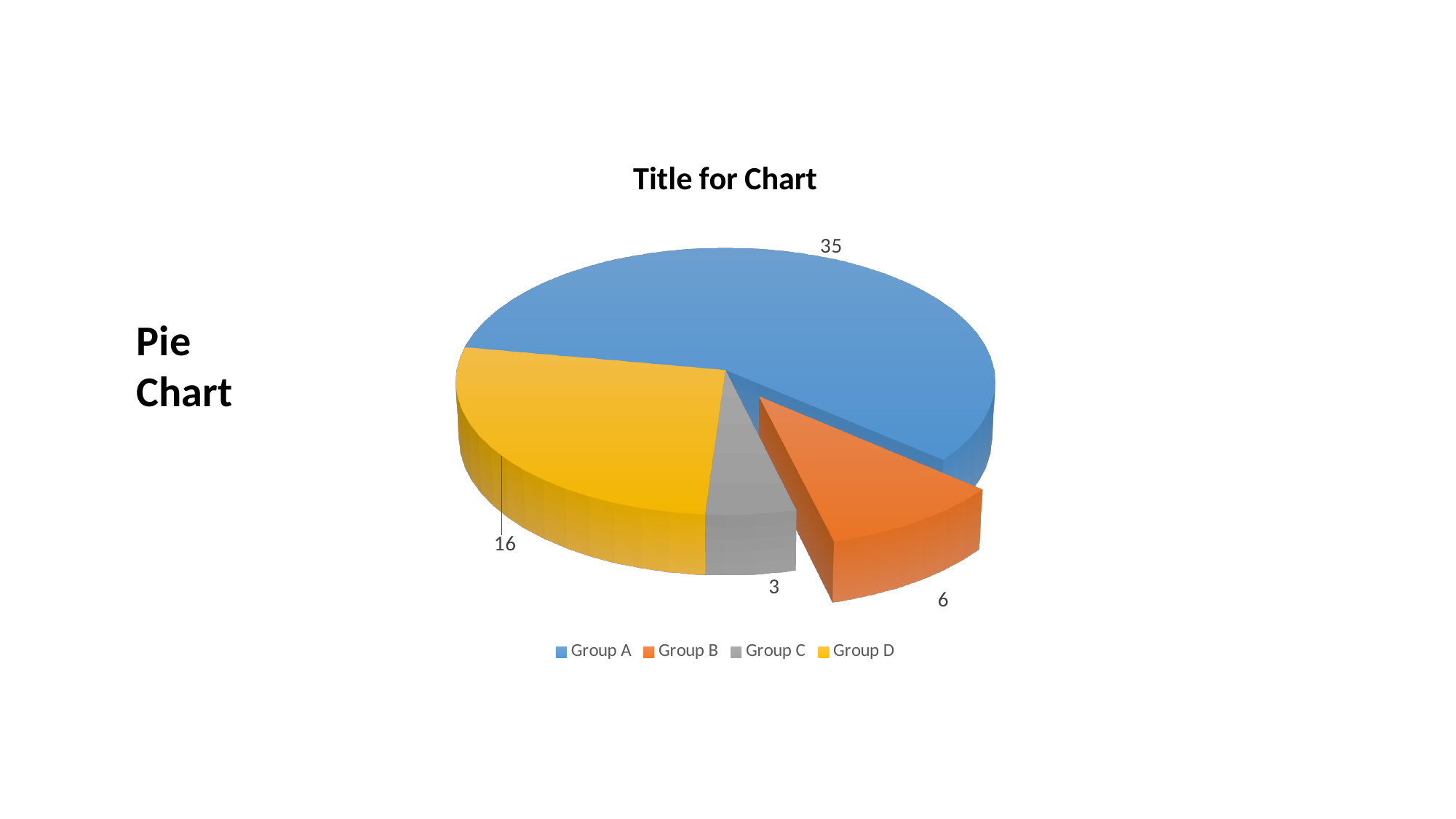
What share of the total does Group B represent? 10% Which group has the largest slice? Group A Which is larger, the value for Group B or the value for Group C? Group B What is the value for Group C? 3 What is the value for Group B? 6 How many slices does the pie chart have? 4 What is the difference between the values for Group A and Group D? 19 Which group has the smallest slice? Group C What is the title of the chart? Title for Chart What is the value for Group D? 16 What kind of chart is shown on the slide? Pie chart What is the value for Group A? 35